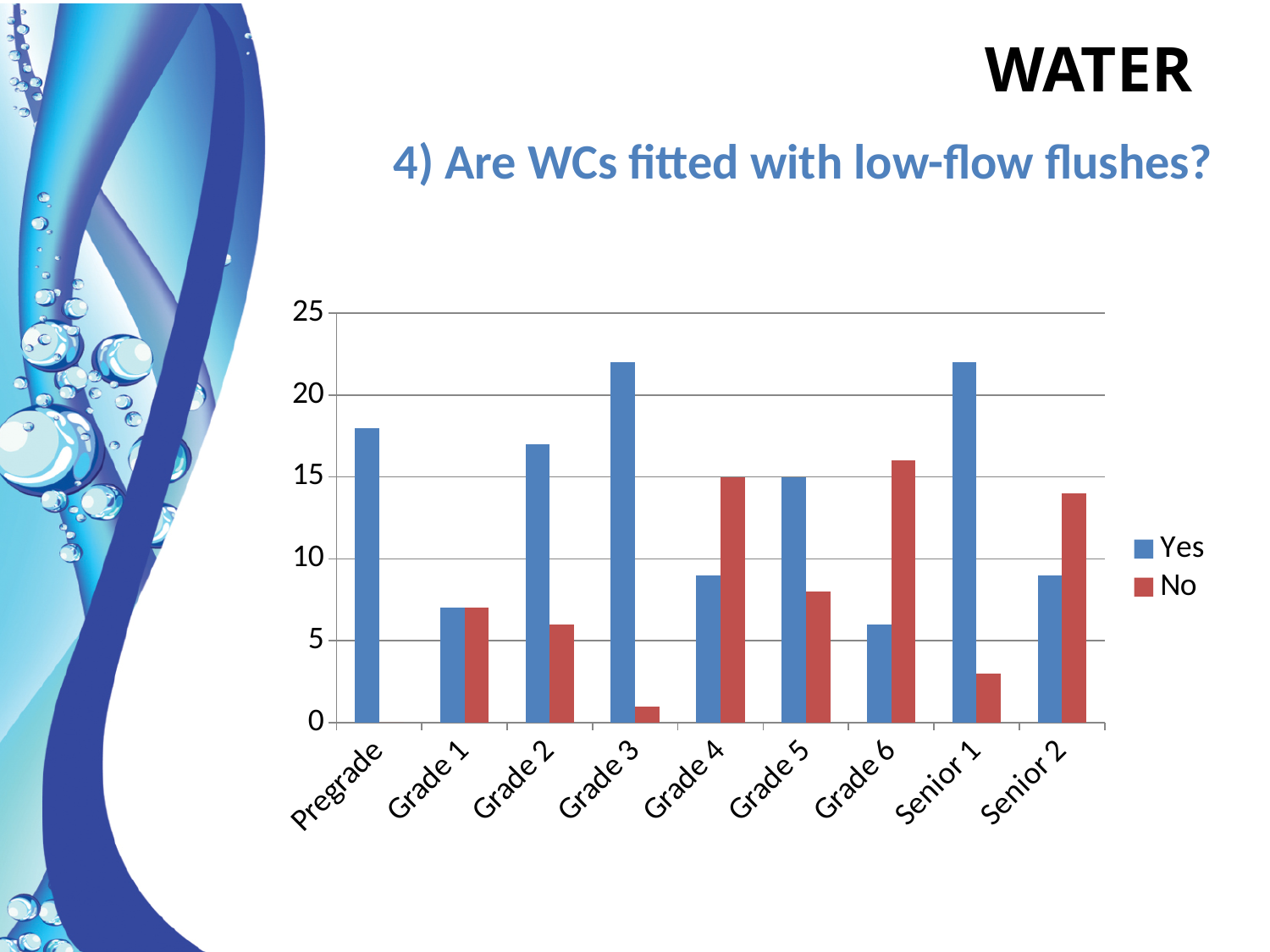
Is the No value for Senior 1 greater or less than 5? less For Grade 4, which is larger, the Yes value or the No value? No How many grade categories are shown on the x axis? 9 For Grade 2, which is larger, the Yes value or the No value? Yes Is the Yes value for Grade 6 greater or less than 10? less Is the Yes value for Pregrade greater or less than 15? greater For Senior 2, which is larger, the Yes value or the No value? No What are the two series named in the legend? Yes and No How many series does the legend list? 2 What kind of chart is shown on the slide? bar chart